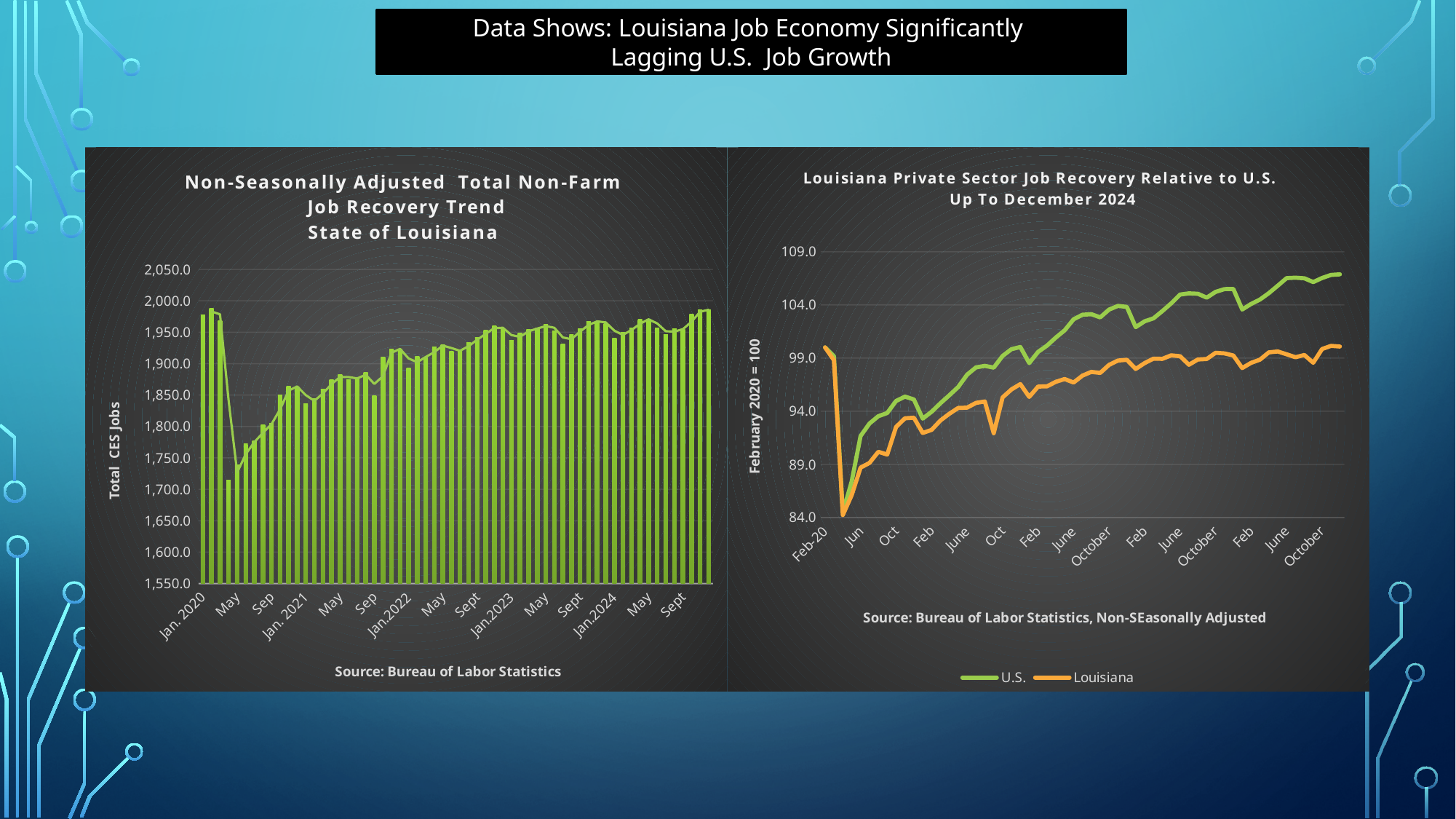
What kind of chart is the left chart, 'Non-Seasonally Adjusted Total Non-Farm Job Recovery Trend State of Louisiana'? bar chart In the right chart, how many series does the legend list? 2 In the right chart, is the value for Louisiana at October 2024 greater or less than 104.0? less In the right chart, which series is higher at October 2024, U.S. or Louisiana? U.S. In the right chart, is the lowest value of the Louisiana series greater or less than 89.0? less What is the y-axis label of the right chart? February 2020 = 100 In the left chart, is the value for May 2020 greater or less than 1,800.0? less In the right chart, do the U.S. and Louisiana series generally rise or fall from June 2020 to October 2024? rise What kind of chart is the right chart, 'Louisiana Private Sector Job Recovery Relative to U.S. Up To December 2024'? line chart